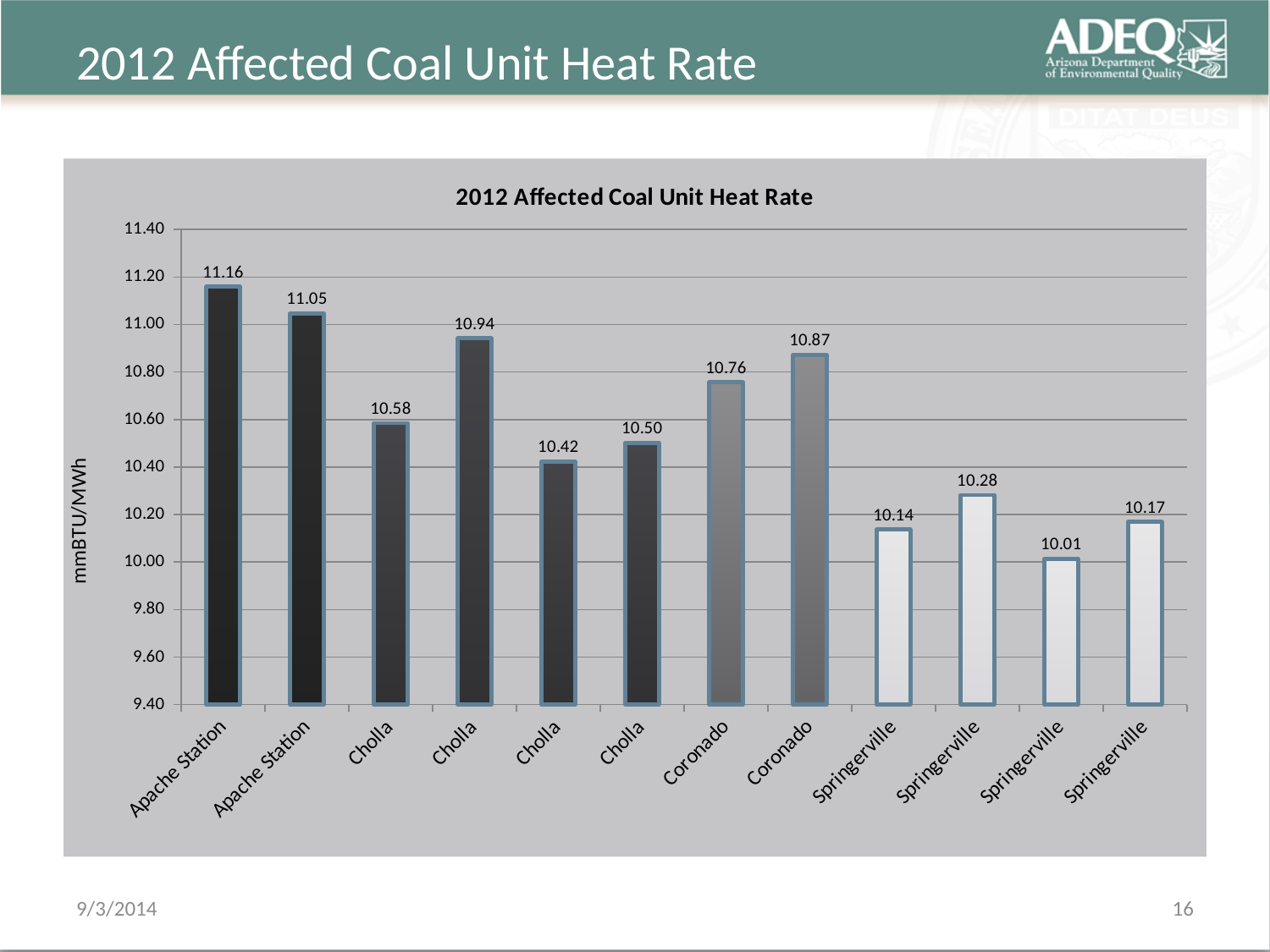
What is the value of the second Coronado bar? 10.87 Which of the two Coronado bars is larger, the first or the second? the second (10.87) What is the title of the chart? 2012 Affected Coal Unit Heat Rate Is the value for the leftmost Apache Station bar greater or less than 11.00? greater What is the difference between the two Apache Station bars (11.16 and 11.05)? 0.11 Which bar has the highest value in the chart? the first Apache Station bar (11.16) Which bar has the lowest value in the chart? the third Springerville bar (10.01) What is the label on the vertical axis of the chart? mmBTU/MWh What is the value of the leftmost bar (the first Apache Station bar)? 11.16 What is the value of the rightmost bar (the fourth Springerville bar)? 10.17 What type of chart is shown on the slide? bar chart How many bars are plotted in the chart? 12